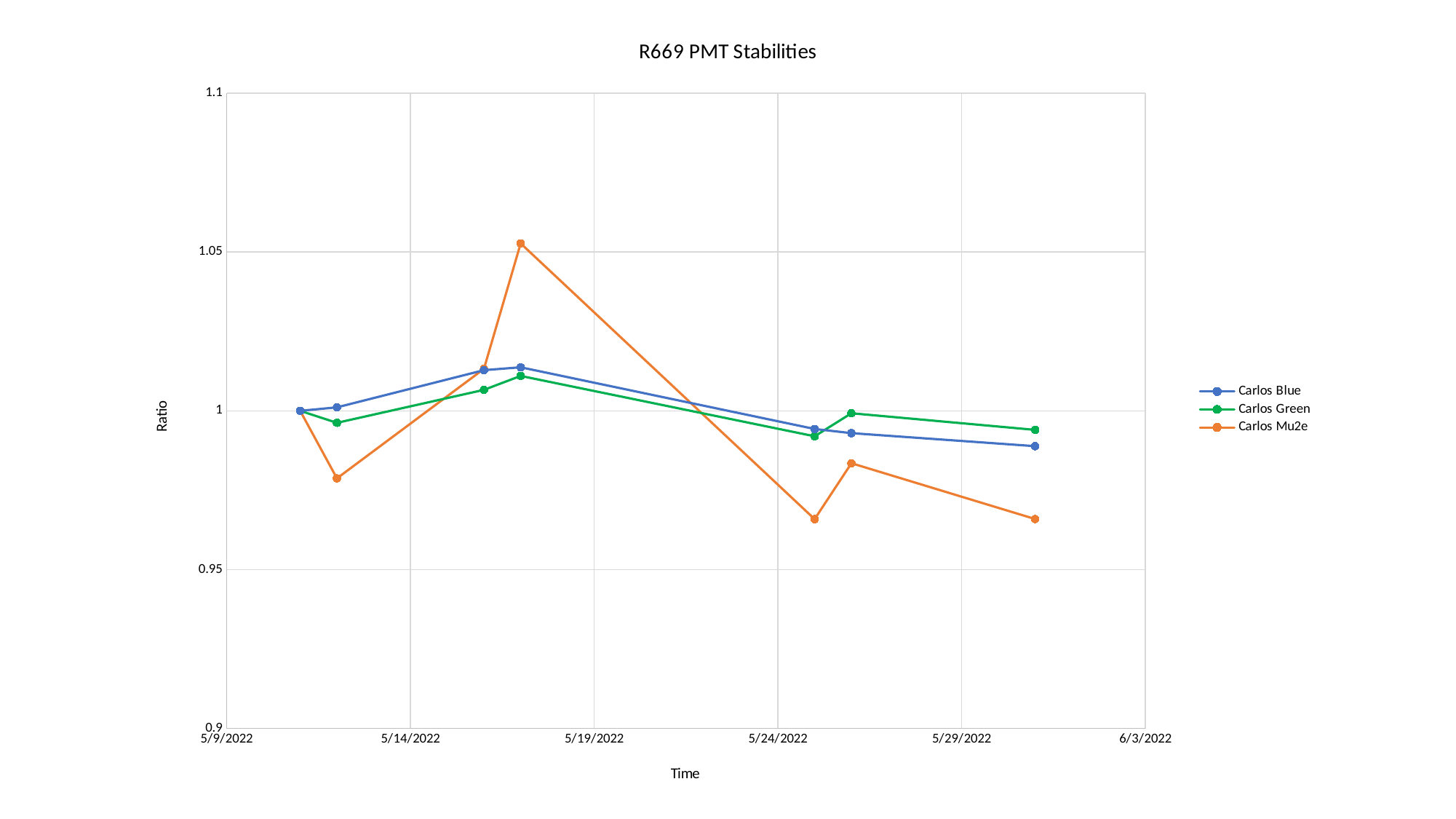
Is the lowest value for Carlos Mu2e greater or less than 0.95? greater Does the Carlos Blue series rise or fall from its peak near 5/17/2022 to its final point? fall Is the highest value for Carlos Blue greater or less than 1.05? less Is the last plotted value for Carlos Mu2e greater or less than 1? less What kind of chart is shown on the slide? line chart Which series reaches the highest ratio value on the chart? Carlos Mu2e Which series reaches the lowest ratio value on the chart? Carlos Mu2e How many data points are plotted for the Carlos Mu2e series? 7 How many series does the legend list? 3 What is the title of the chart? R669 PMT Stabilities At the last plotted date, which series has the larger value, Carlos Blue or Carlos Mu2e? Carlos Blue What is the label of the vertical axis? Ratio